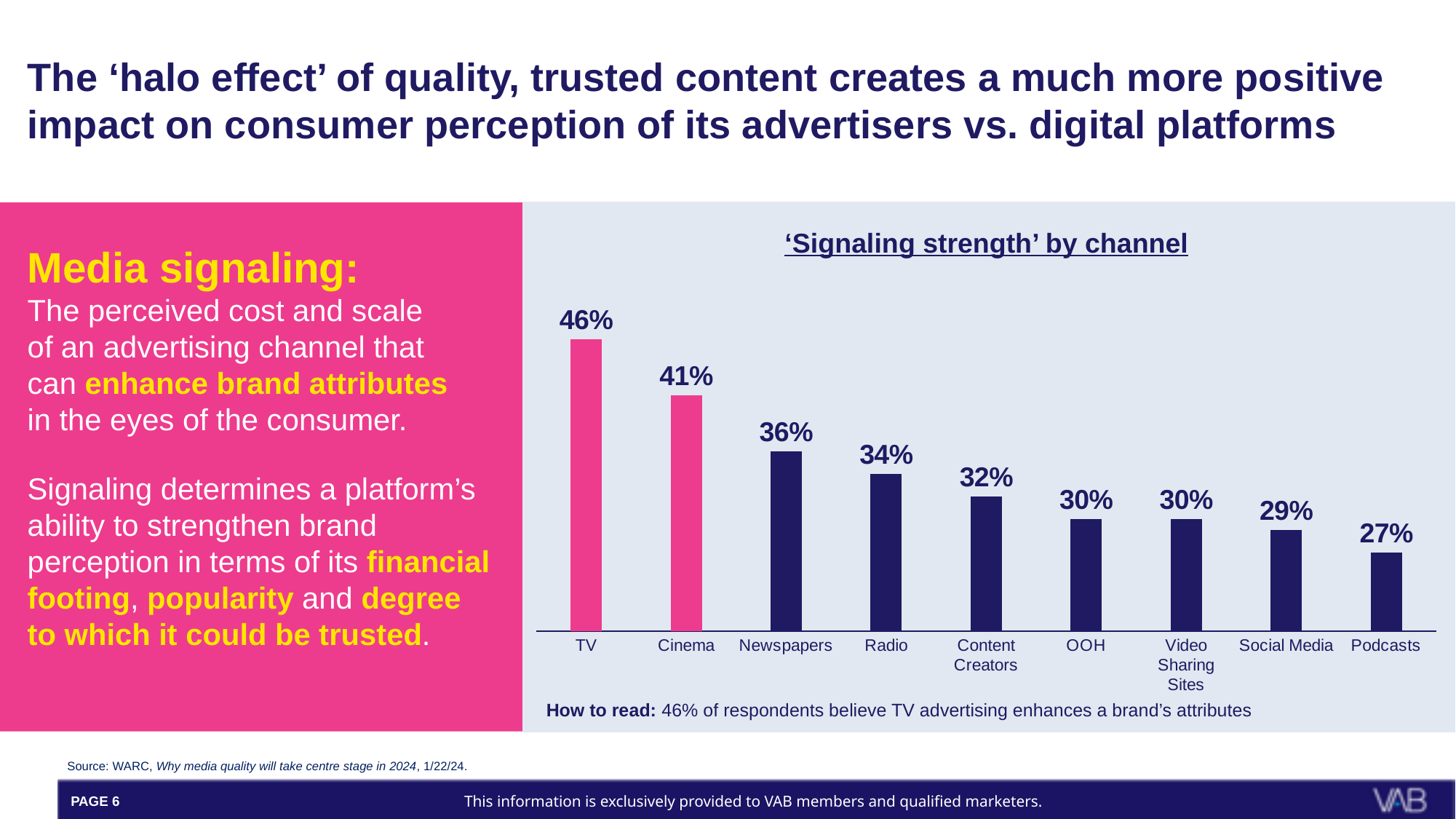
What is the signaling strength value for Podcasts? 27% What kind of chart is shown on the slide? Bar chart How many channels are shown in the chart? 9 What is the title of the chart? 'Signaling strength' by channel Which channel has the highest signaling strength? TV Which has a higher value, Cinema or Content Creators? Cinema What is the difference between the values for TV and Cinema? 5% Which channel has the lowest signaling strength? Podcasts What is the signaling strength value for Newspapers? 36% What is the difference between the values for Radio and Social Media? 5% What is the signaling strength value for TV? 46% Do the values rise or fall moving from left to right across the channels? Fall